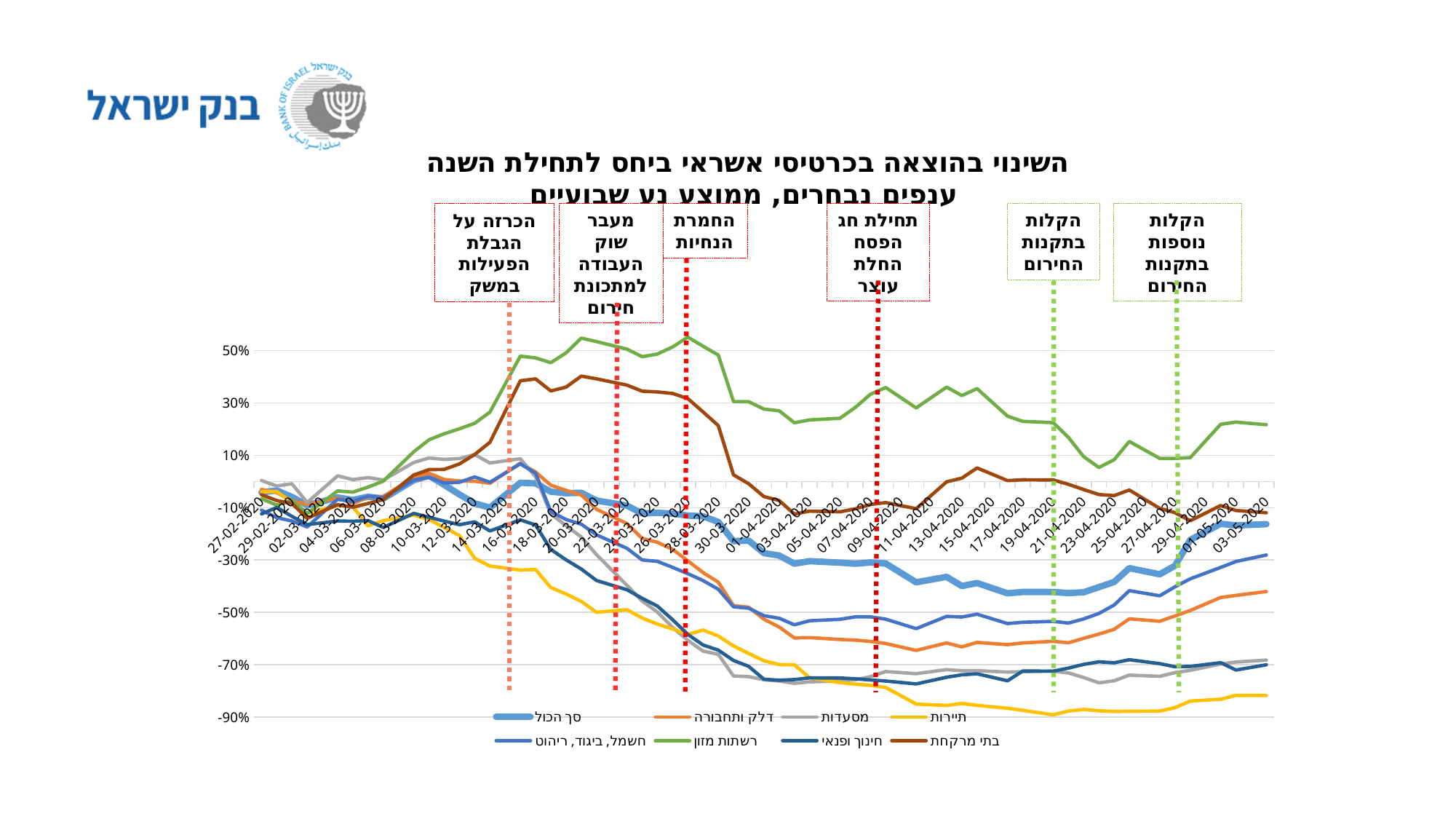
How many dotted vertical annotation lines are drawn on the chart? 6 Which series has the highest value at 03-05-2020? רשתות מזון Is the value for דלק ותחבורה at 03-05-2020 greater or less than -30%? less How many series does the legend list? 8 Is the value for סך הכול at 21-04-2020 greater or less than -30%? less Which series has the lowest value at 21-04-2020? תיירות At 03-05-2020, which is larger: the value for בתי מרקחת or the value for דלק ותחבורה? בתי מרקחת Is the value for רשתות מזון at 16-03-2020 greater or less than 30%? greater Which series has the highest value at 16-03-2020? רשתות מזון What kind of chart is shown on the slide? line chart Does the value for רשתות מזון rise or fall between 27-02-2020 and 16-03-2020? rise